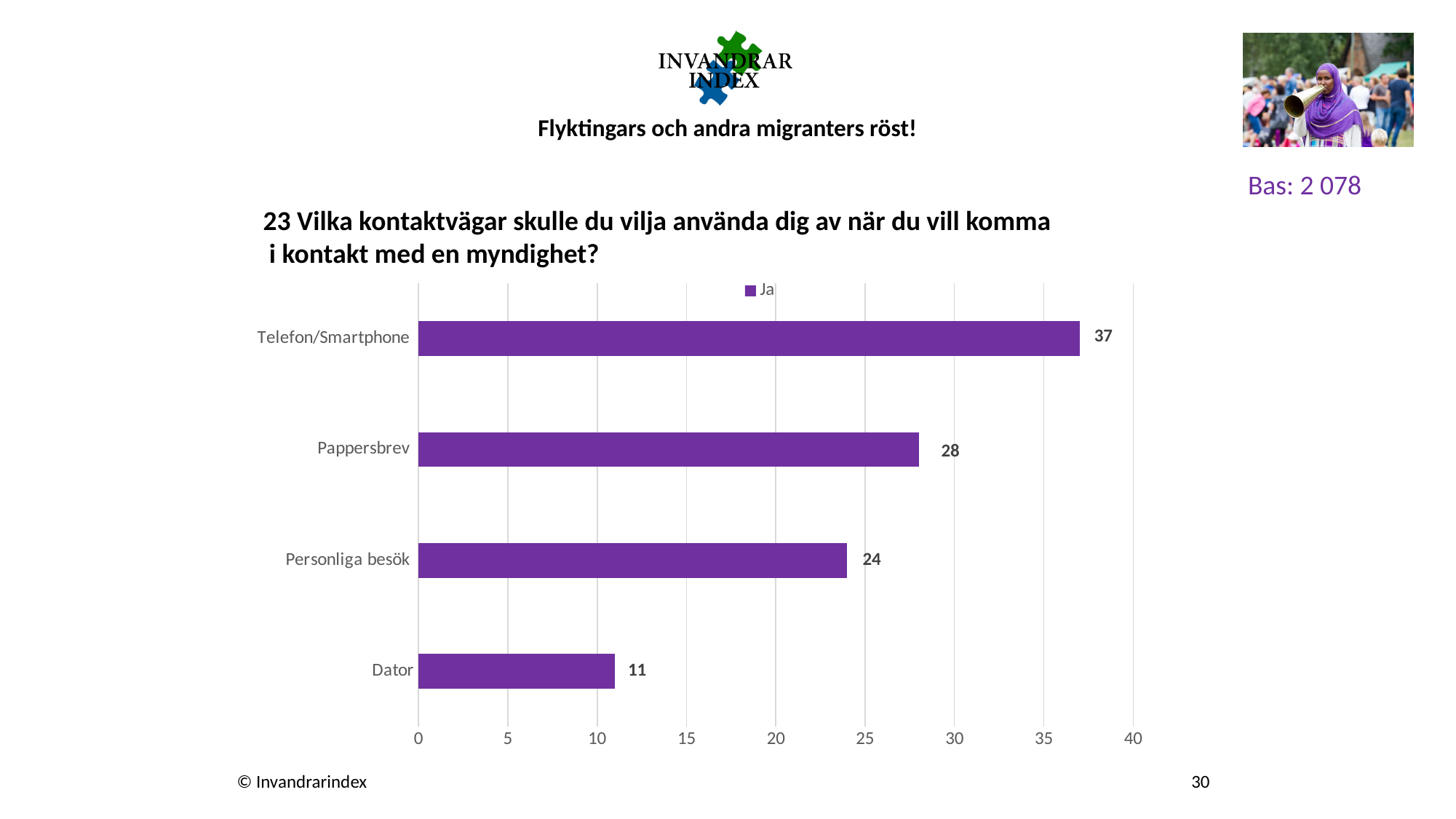
What is the value for Pappersbrev? 28 Which category has the highest value? Telefon/Smartphone What kind of chart is shown on the slide? Bar chart What is the value for Personliga besök? 24 How many categories are shown in the chart? 4 Which category has the lowest value? Dator What is the difference between the values for Telefon/Smartphone and Pappersbrev? 9 What series name does the legend show? Ja What is the difference between the values for Personliga besök and Dator? 13 What is the value for Dator? 11 What is the value for Telefon/Smartphone? 37 Which is larger, the value for Pappersbrev or the value for Personliga besök? Pappersbrev